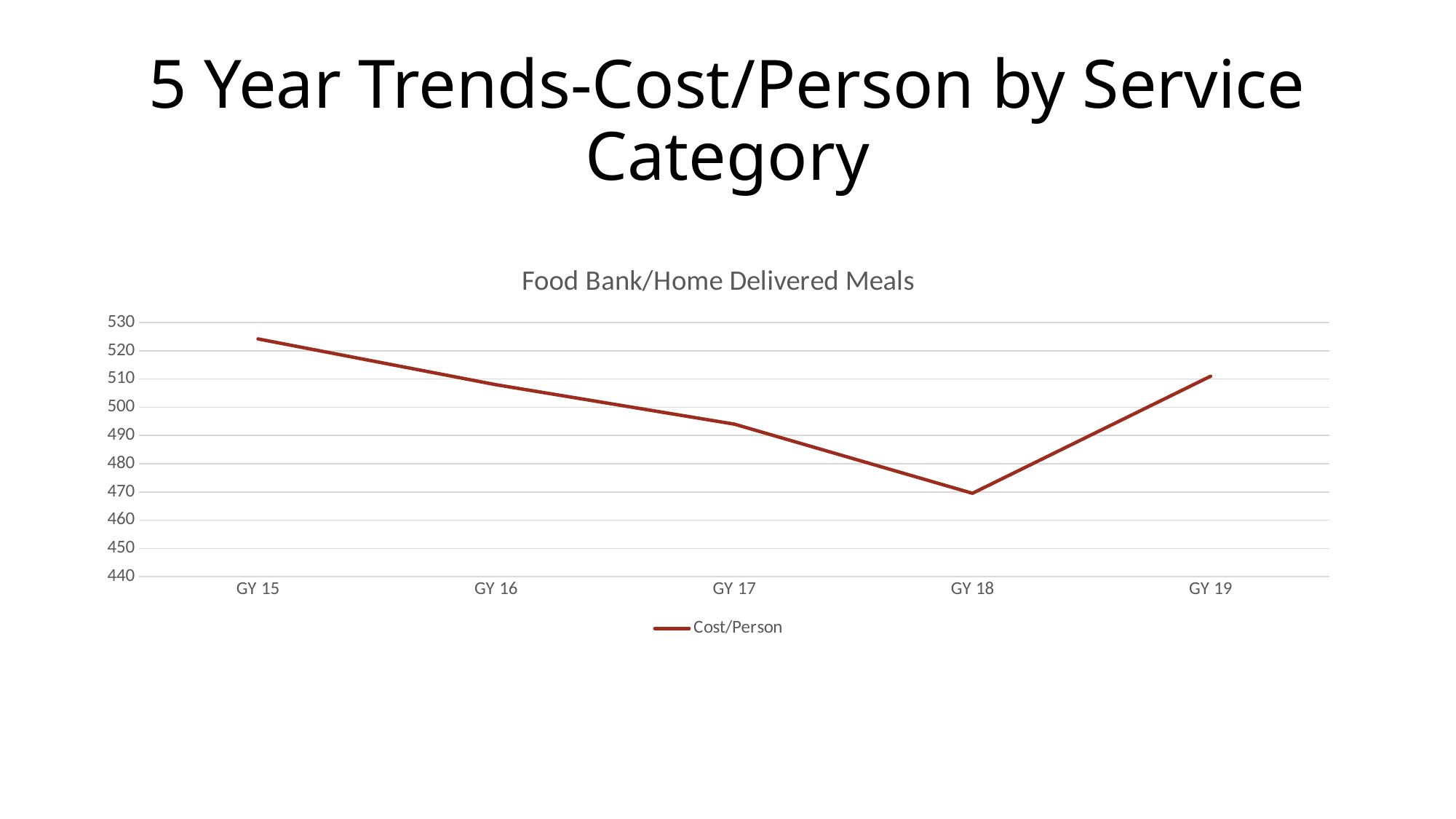
How many years are plotted on the x axis? 5 What is the title of the chart? Food Bank/Home Delivered Meals How many series does the legend list? 1 Is the Cost/Person for GY 16 greater or less than 500? greater Which year has the highest Cost/Person? GY 15 Is the Cost/Person for GY 15 greater or less than 530? less Which year has the lowest Cost/Person? GY 18 Is the Cost/Person for GY 18 greater or less than 480? less Does the Cost/Person rise or fall from GY 15 to GY 18? fall Which is larger, the Cost/Person for GY 15 or for GY 19? GY 15 What kind of chart is shown on the slide? line chart What is the name of the series shown in the legend? Cost/Person